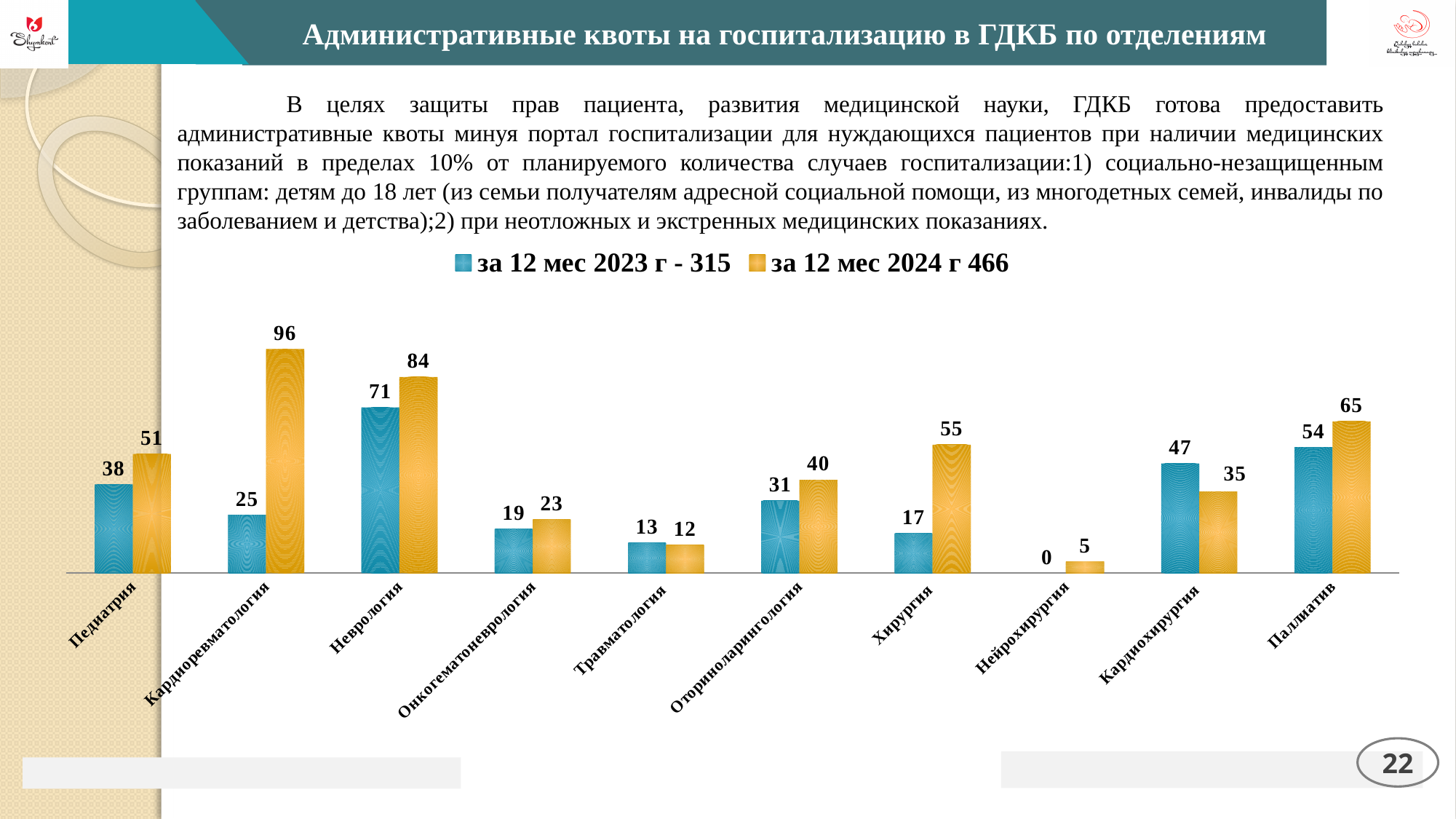
Which is larger for Кардиохирургия: the 2023 value or the 2024 value? the 2023 value (47) How many categories (departments) are shown on the x axis? 10 What is the value for Неврология in the series 'за 12 мес 2023 г - 315'? 71 What is the value for Кардиоревматология in the series 'за 12 мес 2024 г 466'? 96 What kind of chart is shown on the slide? bar chart What is the difference between the 2024 and 2023 values for Кардиоревматология? 71 What is the difference between the 2023 and 2024 values for Травматология? 1 How many series does the legend list? 2 What colour are the bars for the series 'за 12 мес 2024 г 466'? orange/yellow Which category has the lowest value in the series 'за 12 мес 2023 г - 315'? Нейрохирургия Which category has the highest value in the series 'за 12 мес 2024 г 466'? Кардиоревматология What is the value for Нейрохирургия in the series 'за 12 мес 2023 г - 315'? 0